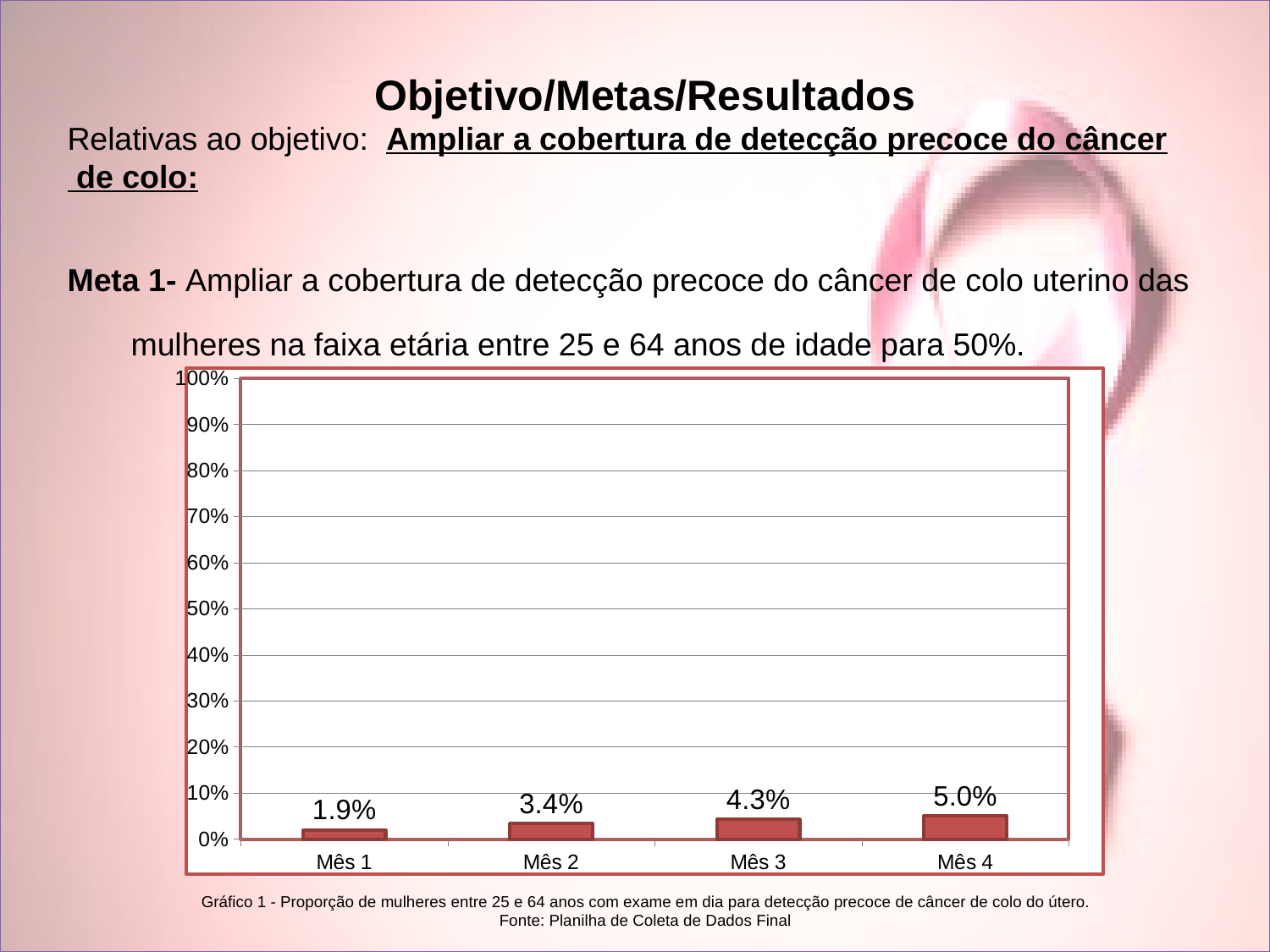
Which month has the highest value? Mês 4 What is the value for Mês 3? 4.3% How many months are shown on the x axis? 4 Which is larger, the value for Mês 2 or the value for Mês 3? Mês 3 What is the value for Mês 4? 5.0% What is the difference between the values for Mês 4 and Mês 1? 3.1% Is the value for Mês 4 greater or less than 10%? less What kind of chart is shown on the slide? bar chart What is the difference between the values for Mês 2 and Mês 1? 1.5% Do the values rise or fall from Mês 1 to Mês 4? rise What is the value for Mês 1? 1.9% Which month has the lowest value? Mês 1